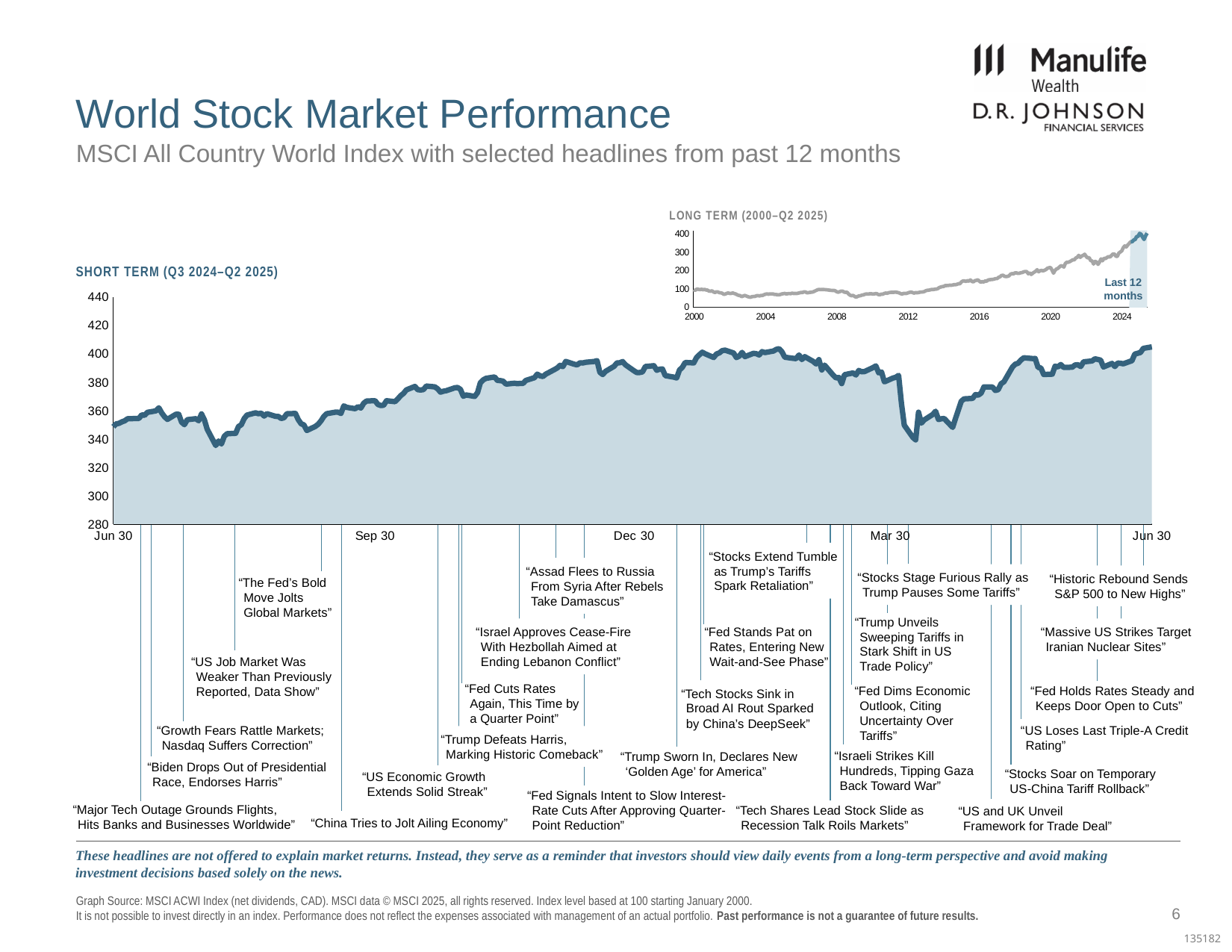
How many year labels are shown on the x axis of the LONG TERM chart? 7 On the LONG TERM chart, is the index value in 2008 greater or less than 200? less On the LONG TERM chart, does the index generally rise or fall from 2000 to 2025? rise On the SHORT TERM chart, is the index value at Sep 30 greater or less than 340? greater What kind of chart is the LONG TERM (2000–Q2 2025) chart? line chart On the SHORT TERM chart, is the index value at the starting Jun 30 greater or less than 340? greater What label is given to the shaded region at the right end of the LONG TERM chart? Last 12 months How many date labels are shown on the x axis of the SHORT TERM chart? 5 What kind of chart is the SHORT TERM (Q3 2024–Q2 2025) chart? area chart